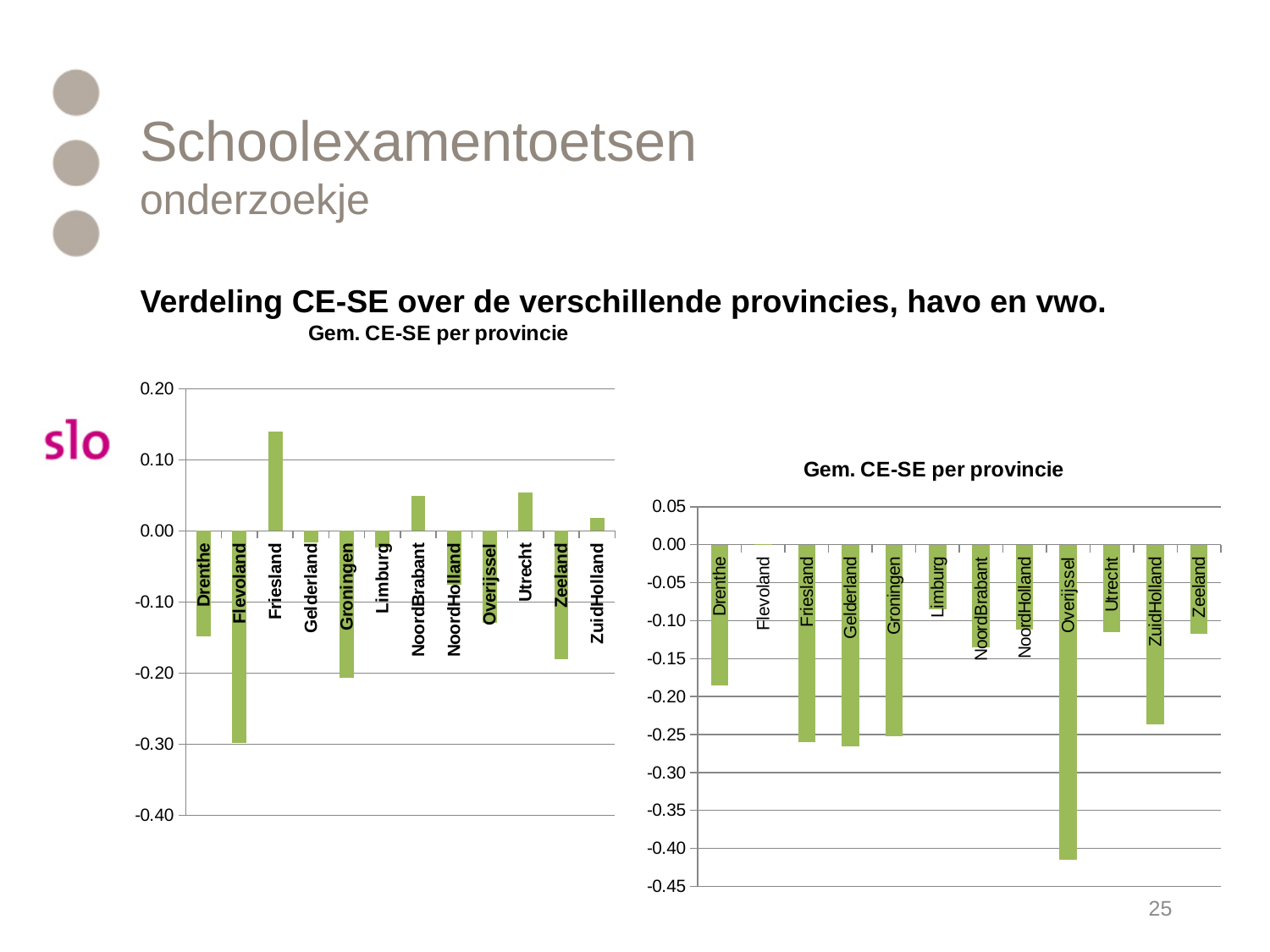
On the left chart, which province has the lowest value? Flevoland How many provinces are shown on the right chart? 12 On the right chart, which is larger, the value for Limburg or the value for Overijssel? Limburg On the left chart, is the value for Friesland greater or less than 0.10? greater How many provinces are shown on the left chart? 12 On the right chart, is the value for Overijssel greater or less than -0.40? less On the left chart, which province has the highest value? Friesland What is the title of the right chart? Gem. CE-SE per provincie On the left chart, is the value for Flevoland greater or less than -0.20? less What kind of chart is the left chart on the slide? bar chart On the right chart, which province has the lowest value? Overijssel